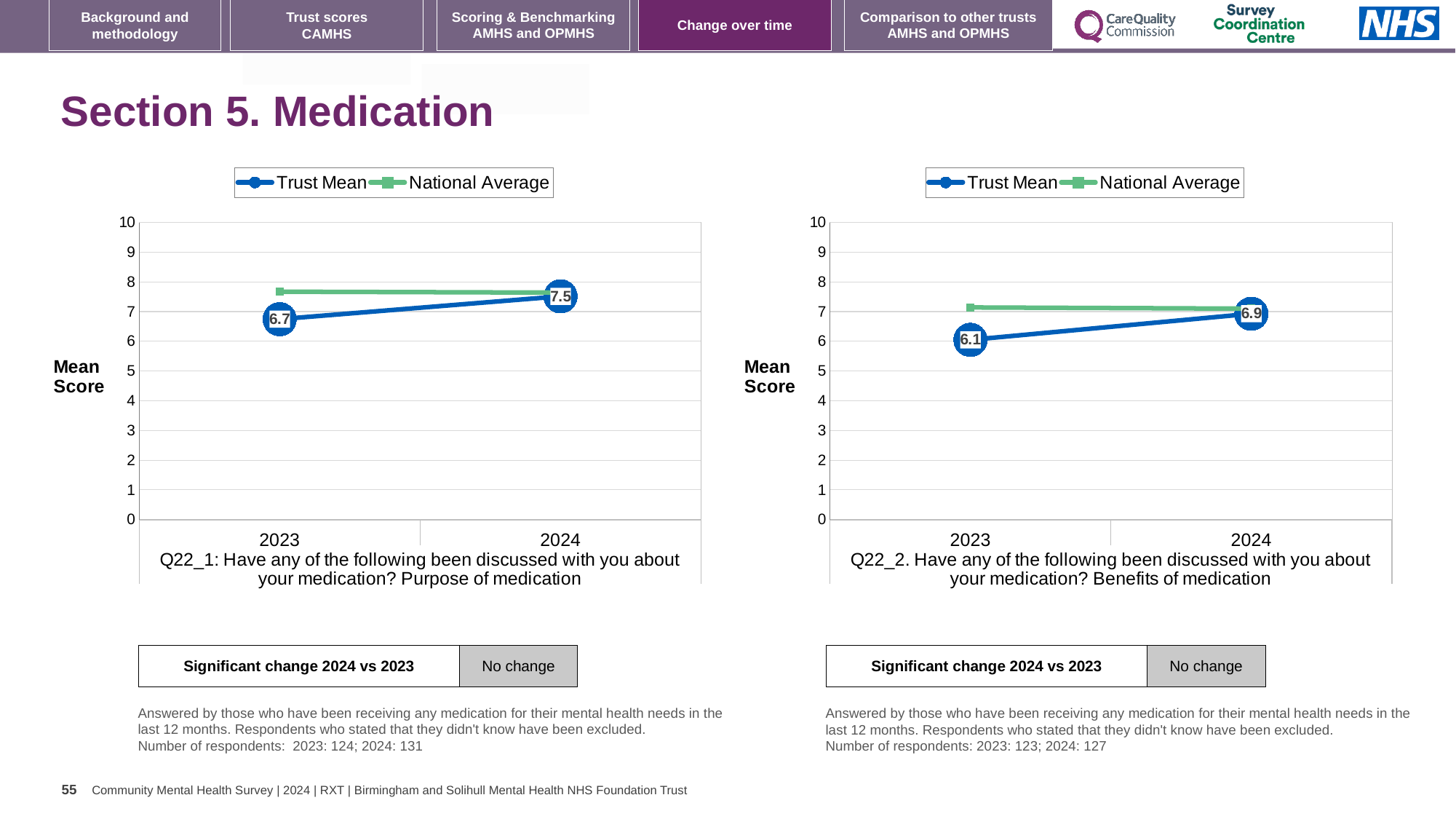
In the left chart (Q22_1: Purpose of medication), by how much did the Trust Mean change from 2023 to 2024? 0.8 In the left chart (Q22_1: Purpose of medication), which is higher in 2023, the Trust Mean or the National Average? National Average In the right chart (Q22_2: Benefits of medication), by how much did the Trust Mean change from 2023 to 2024? 0.8 In the left chart (Q22_1: Purpose of medication), is the National Average for 2023 greater or less than 7? greater In the right chart (Q22_2: Benefits of medication), which is higher in 2023, the Trust Mean or the National Average? National Average In the right chart (Q22_2: Benefits of medication), what is the Trust Mean score for 2024? 6.9 In the right chart (Q22_2: Benefits of medication), does the Trust Mean rise or fall from 2023 to 2024? rise What kind of chart is the right chart (Q22_2: Benefits of medication)? line chart In the left chart (Q22_1: Purpose of medication), what is the Trust Mean score for 2024? 7.5 In the right chart (Q22_2: Benefits of medication), what is the Trust Mean score for 2023? 6.1 How many series does the legend of the left chart (Q22_1: Purpose of medication) list? 2 In the left chart (Q22_1: Purpose of medication), what is the Trust Mean score for 2023? 6.7